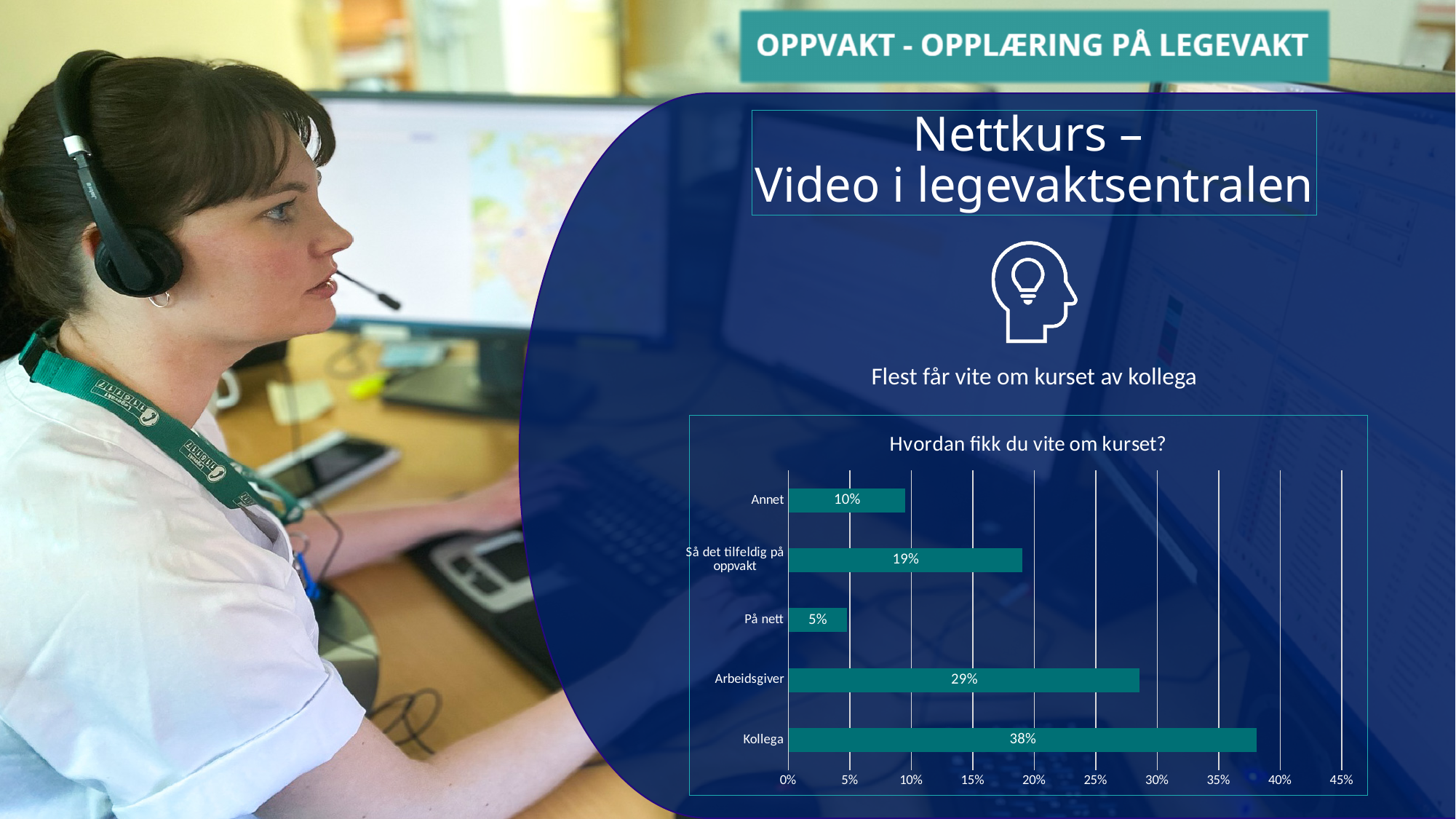
What kind of chart is shown on the slide? Bar chart What percentage of respondents found out about the course from Kollega? 38% Which is larger, the value for Annet or the value for 'Så det tilfeldig på oppvakt'? Så det tilfeldig på oppvakt Which category has the lowest value in the chart? På nett What is the value for Arbeidsgiver in the chart? 29% What is the difference between the values for Kollega and Arbeidsgiver? 9% Which category has the highest value in the chart? Kollega What is the value for På nett? 5% What is the value for 'Så det tilfeldig på oppvakt'? 19% How many categories are shown in the chart? 5 What is the title of the chart? Hvordan fikk du vite om kurset? What is the highest value shown on the x axis of the chart? 45%